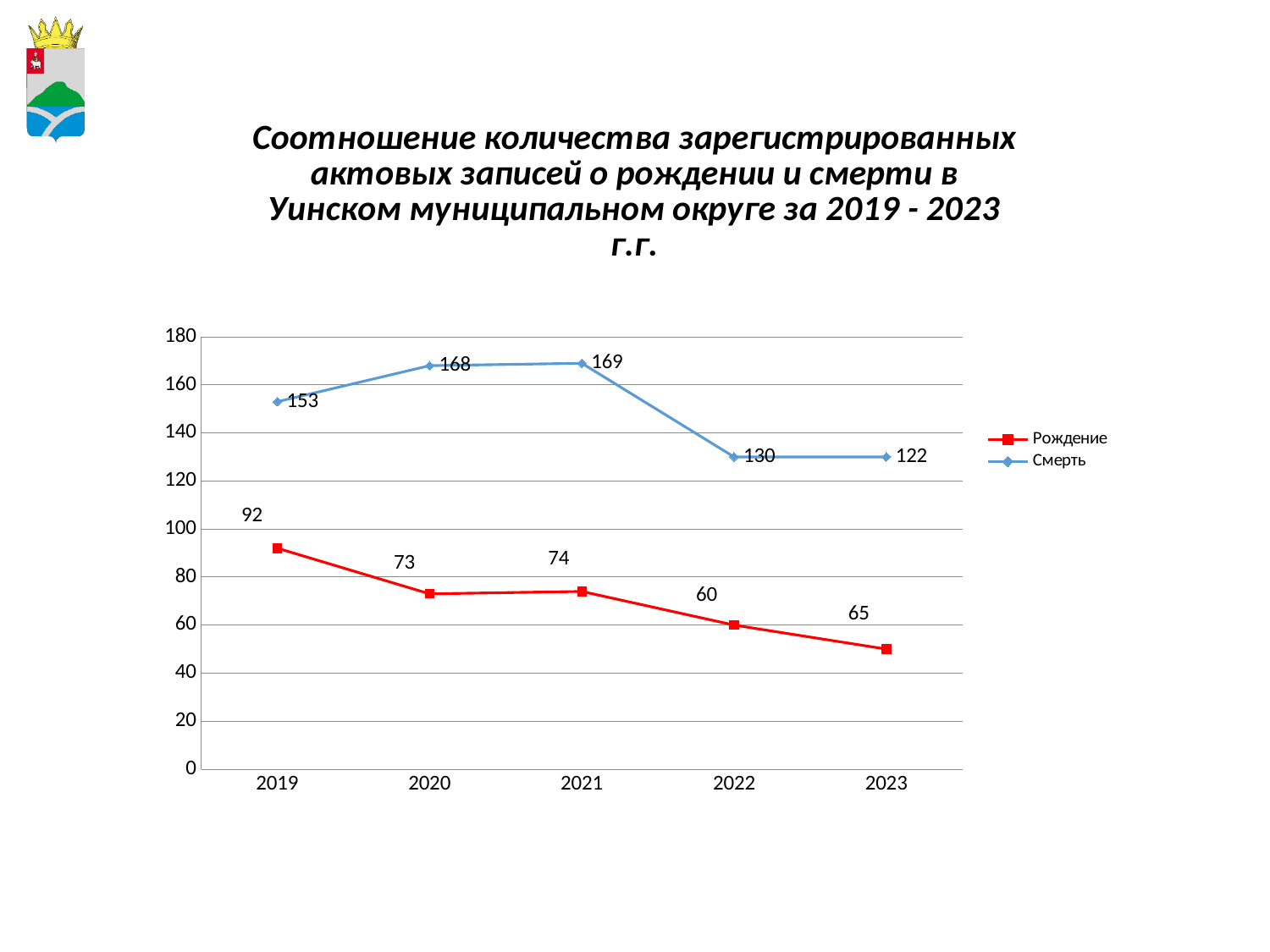
How many series does the legend list? 2 What is the value of Смерть in 2019? 153 What type of chart is shown on the slide? line chart Is the value for Смерть in 2019 greater or less than 140? greater In which year is the Смерть series at its highest? 2021 Which is larger: Рождение in 2019 or Рождение in 2020? 2019 What is the difference between Смерть and Рождение in 2019? 61 How many years are plotted along the x axis? 5 Does the Смерть series rise or fall from 2021 to 2023? fall What is the value of Рождение in 2020? 73